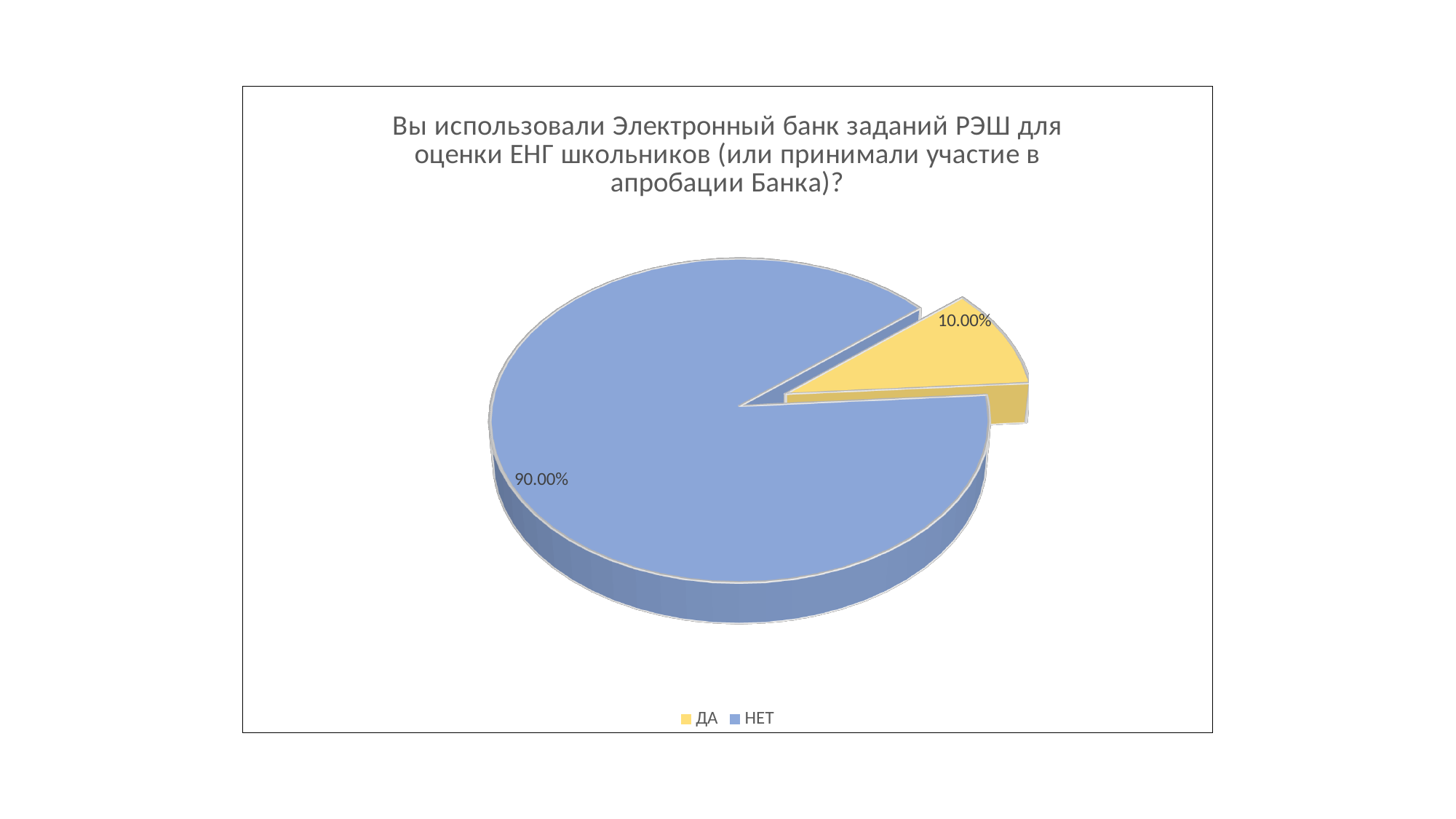
Which is larger, the value for ДА or the value for НЕТ? НЕТ What share of the pie does the ДА slice represent? 10.00% Which category has the largest slice? НЕТ What is the value for ДА? 10.00% What colour is the НЕТ slice? blue What colour is the ДА slice? yellow What kind of chart is shown on the slide? pie chart What is the value for НЕТ? 90.00% What is the difference between the НЕТ and ДА values? 80.00% How many slices does the pie chart have? 2 How many entries does the legend list? 2 Which category has the smallest slice? ДА